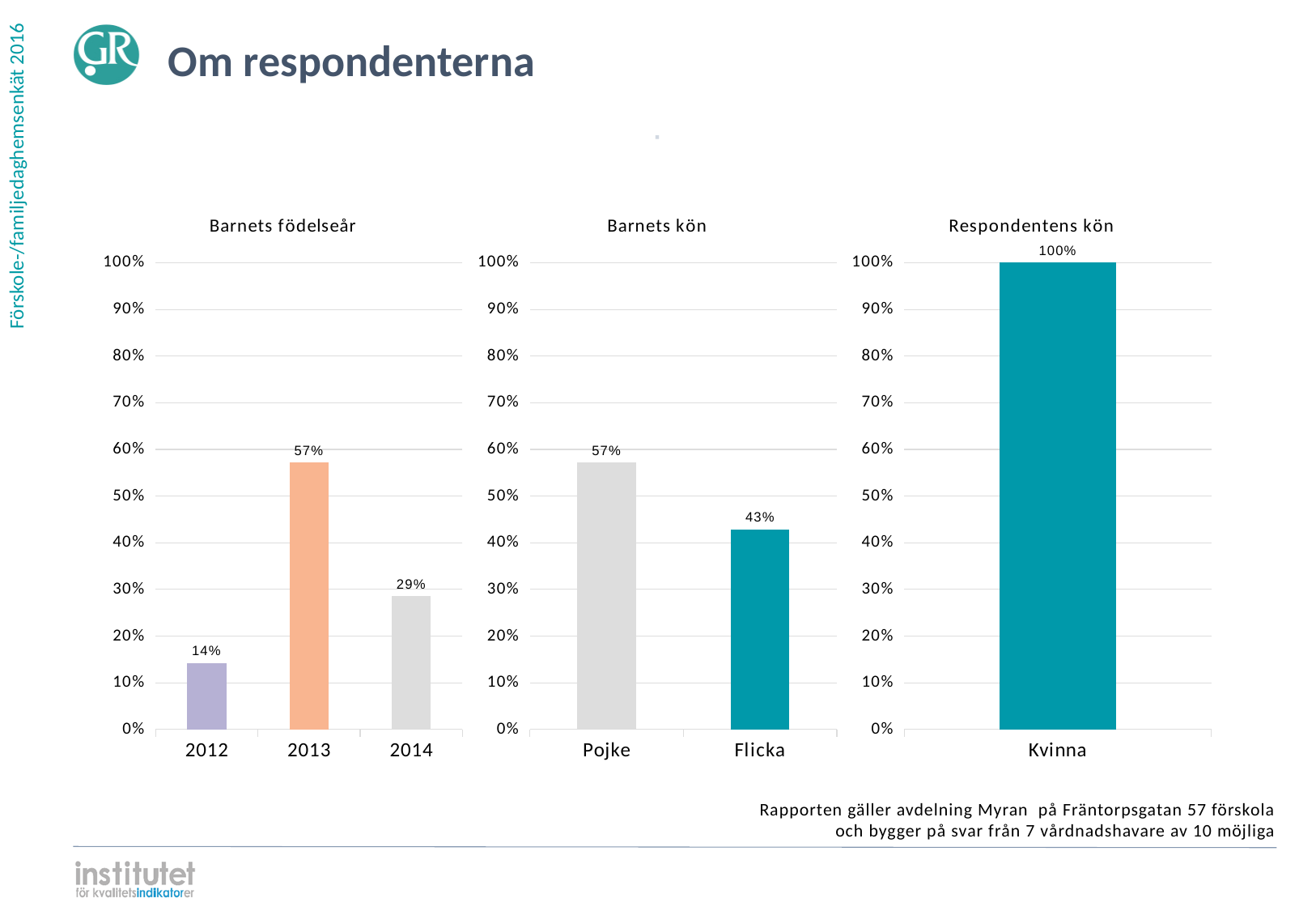
In the 'Respondentens kön' chart, what is the value for Kvinna? 100% What kind of chart is the 'Respondentens kön' chart? Bar chart In the 'Barnets födelseår' chart, which birth year has the highest value? 2013 In the 'Barnets födelseår' chart, what is the difference between the values for 2013 and 2014? 28% In the 'Barnets födelseår' chart, how many birth-year categories are shown? 3 In the 'Barnets födelseår' chart, which birth year has the lowest value? 2012 In the 'Barnets födelseår' chart, what is the value for 2013? 57% In the 'Barnets födelseår' chart, is the value for 2014 greater or less than 20%? greater In the 'Barnets kön' chart, what is the value for Flicka? 43% In the 'Barnets kön' chart, what is the difference between Pojke and Flicka? 14% In the 'Barnets kön' chart, which is larger, Pojke or Flicka? Pojke In the 'Barnets födelseår' chart, what is the value for 2012? 14%